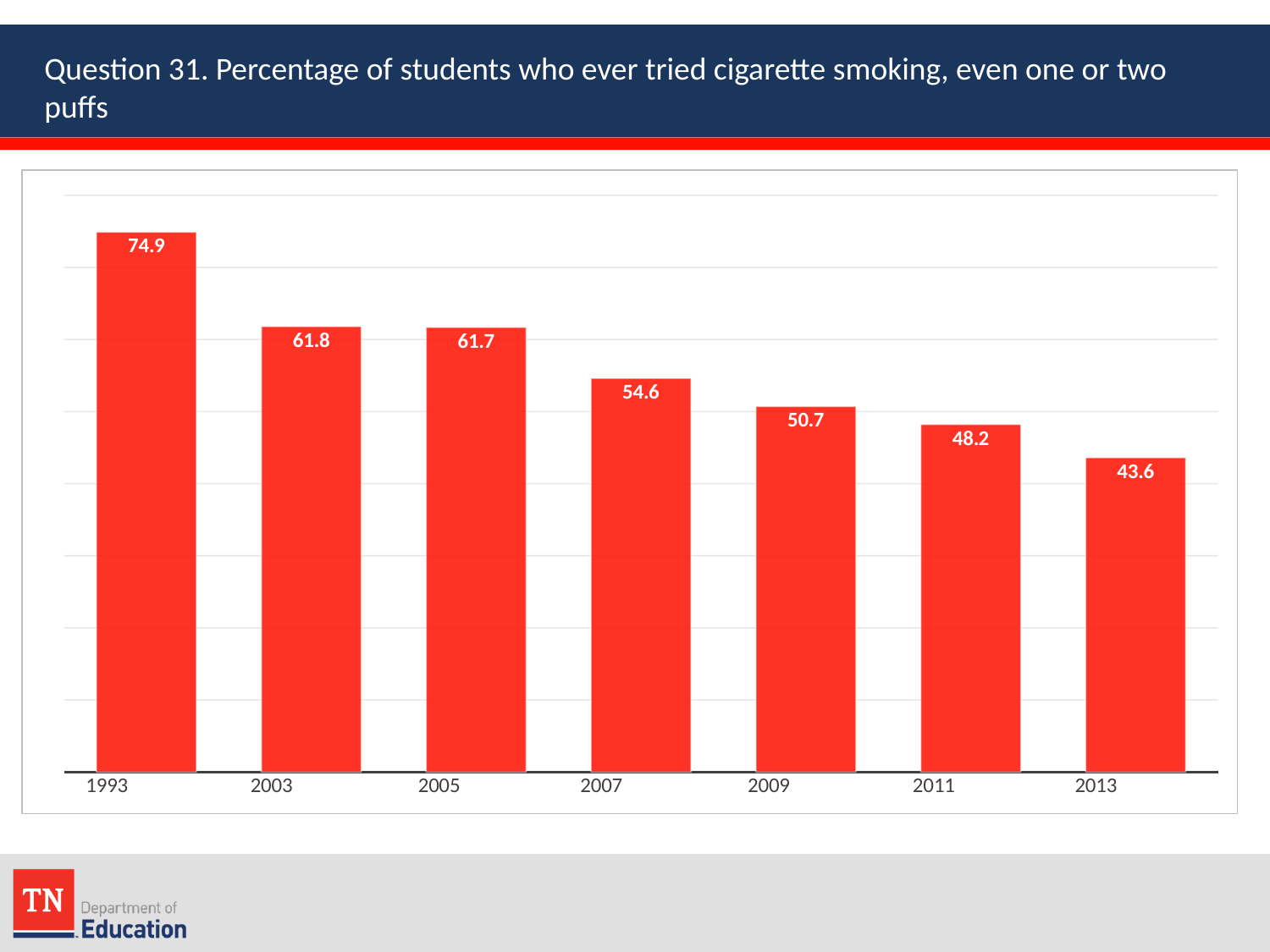
Do the values rise or fall from 1993 to 2013? fall Which year has the highest value? 1993 What is the difference between the values for 1993 and 2013? 31.3 What is the value for 2013? 43.6 What is the value for 2011? 48.2 How many years are shown on the x axis? 7 What kind of chart is shown on the slide? bar chart What is the difference between the values for 2009 and 2011? 2.5 What is the value for 2007? 54.6 Which is larger, the value for 2007 or the value for 2009? 2007 What is the value for 1993? 74.9 Which year has the lowest value? 2013